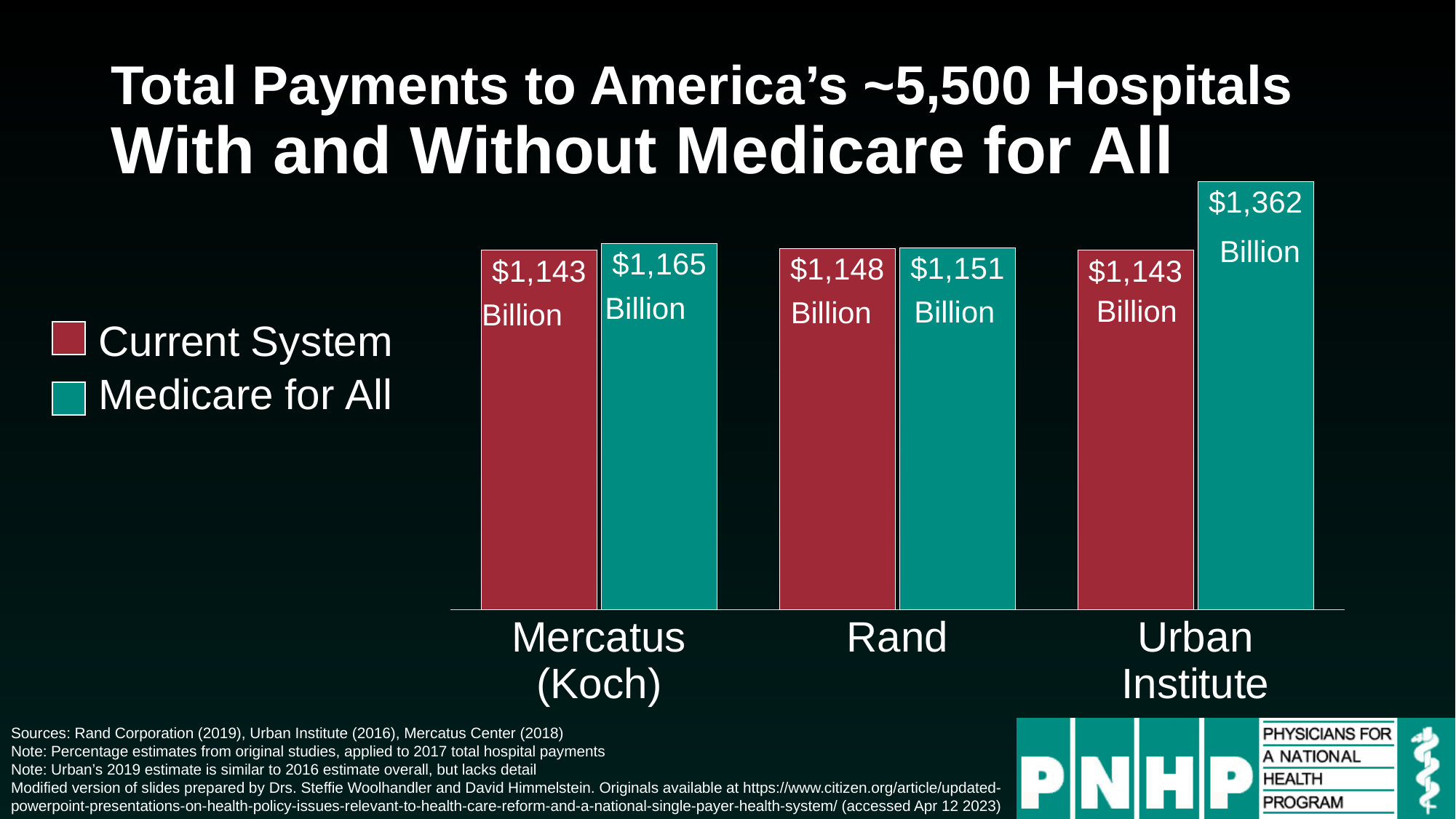
What is the difference between the Medicare for All and Current System values for Mercatus (Koch)? $22 Billion Which study shows the lowest Medicare for All payment estimate? Rand How many studies (categories) are shown on the x axis? 3 What is the Medicare for All value for Urban Institute? $1,362 Billion What kind of chart is shown on the slide? Bar chart How many series does the legend list? 2 Which is larger for Urban Institute: the Current System value or the Medicare for All value? Medicare for All What is the Medicare for All value for Rand? $1,151 Billion What is the difference between the Medicare for All and Current System values for Urban Institute? $219 Billion What is the Current System value for Mercatus (Koch)? $1,143 Billion Which study shows the highest Medicare for All payment estimate? Urban Institute What is the Current System value for Rand? $1,148 Billion